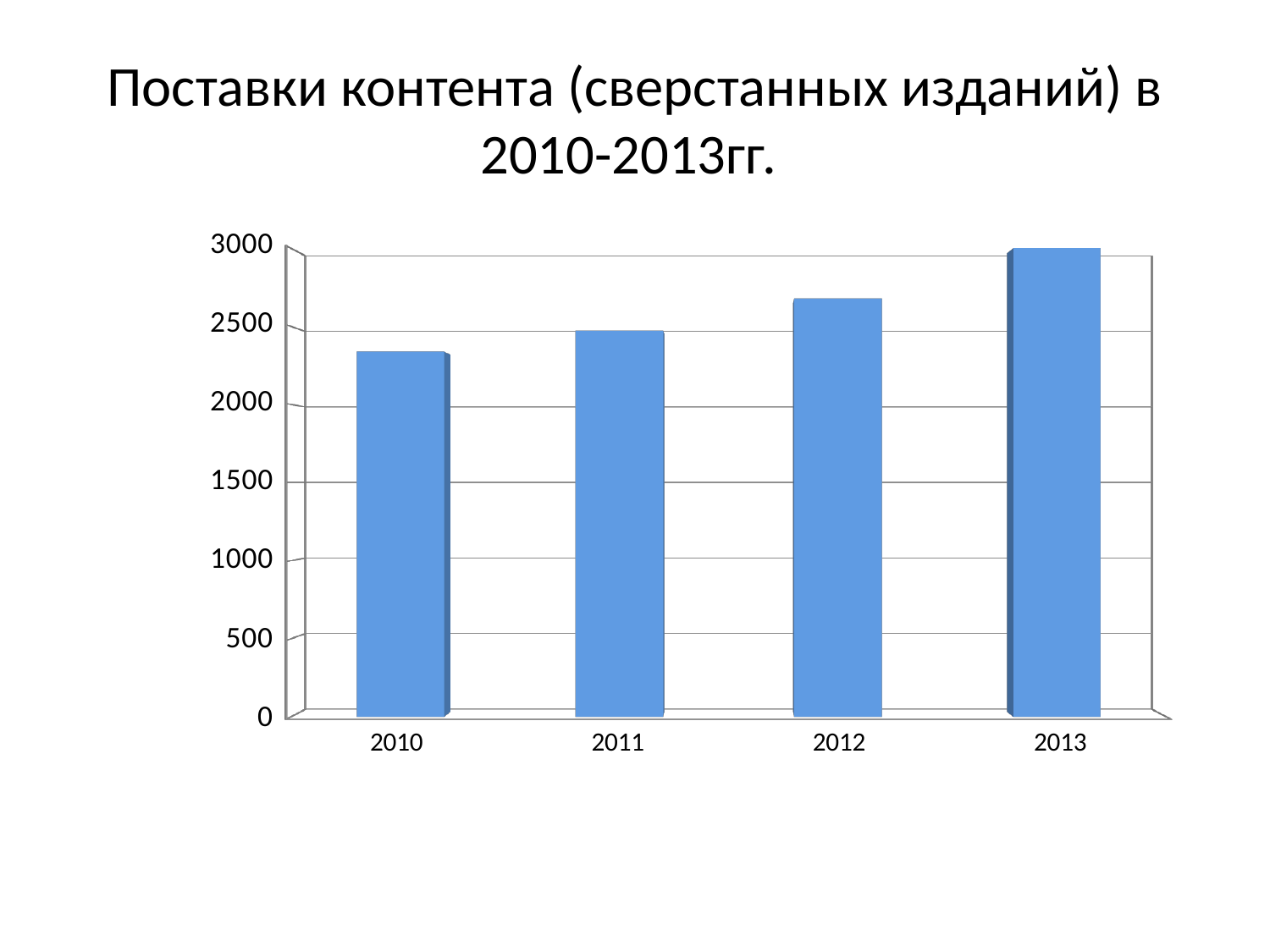
Do the values rise or fall from 2010 to 2013? rise Is the value for 2012 greater or less than 2500? greater Is the value for 2010 greater or less than 2000? greater How many years (bars) are shown on the chart? 4 Which year has the highest value on the chart? 2013 Is the value for 2010 greater or less than 2500? less Which is larger, the value for 2012 or the value for 2010? 2012 What is the title of the slide? Поставки контента (сверстанных изданий) в 2010-2013гг. Which is larger, the value for 2013 or the value for 2011? 2013 What kind of chart is shown on the slide? bar chart Which year has the lowest value on the chart? 2010